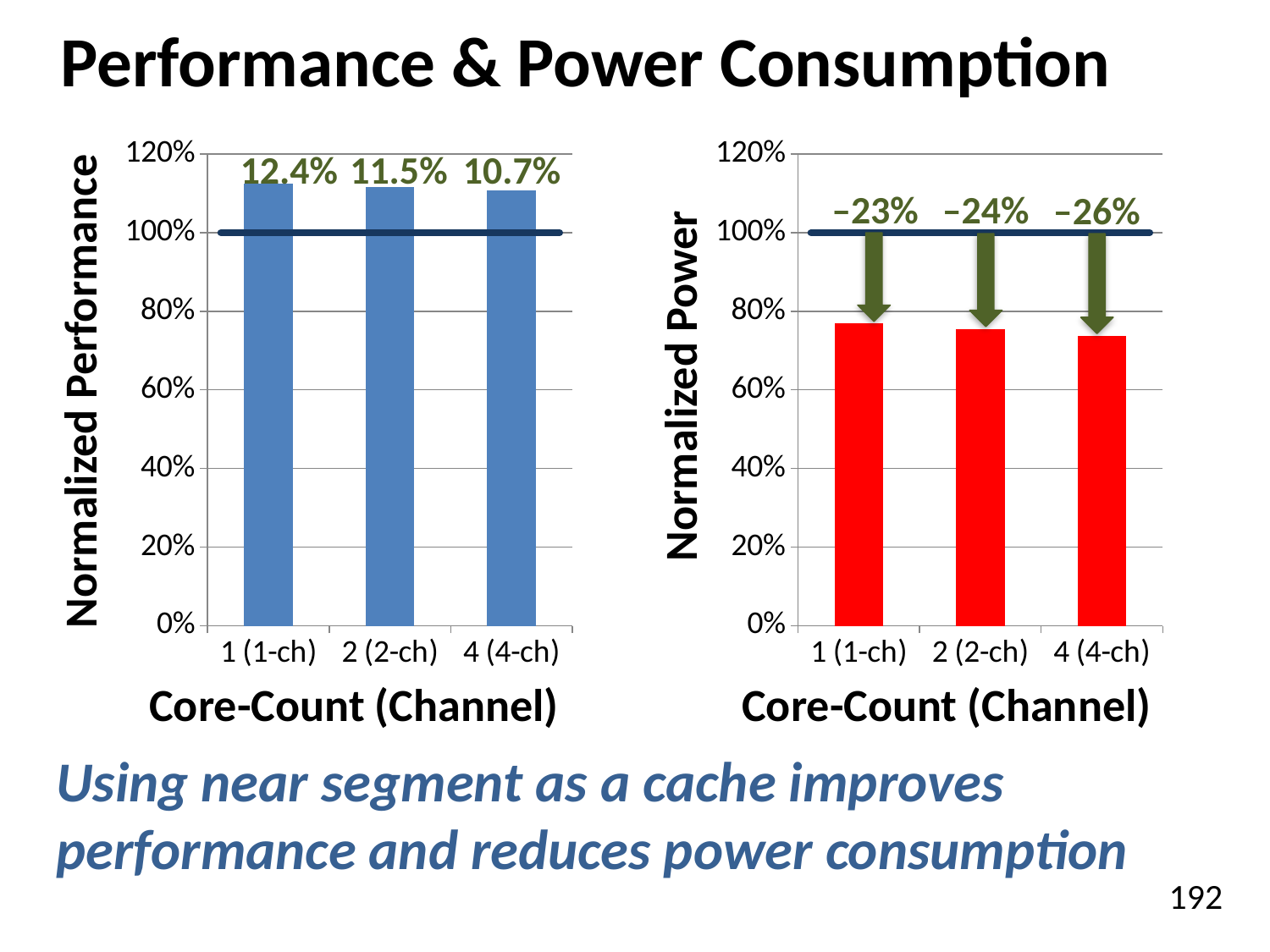
On the Normalized Power chart (right), is the bar for 1 (1-ch) greater or less than 80%? less On the Normalized Performance chart (left), is the bar for 2 (2-ch) greater or less than 100%? greater What kind of chart is the Normalized Performance chart (left)? bar chart What is the x-axis title of the Normalized Power chart (right)? Core-Count (Channel) On the Normalized Performance chart (left), what is the difference between the labelled improvements for 1 (1-ch) and 2 (2-ch)? 0.9% On the Normalized Performance chart (left), which core-count has the largest labelled performance improvement? 1 (1-ch) On the Normalized Power chart (right), what power reduction is labelled for 4 (4-ch)? –26% On the Normalized Power chart (right), what power reduction is labelled for 2 (2-ch)? –24% How many core-count categories are shown on the Normalized Power chart (right)? 3 On the Normalized Performance chart (left), what performance improvement is labelled for 1 (1-ch)? 12.4% On the Normalized Power chart (right), which core-count has the largest labelled power reduction? 4 (4-ch) On the Normalized Performance chart (left), what performance improvement is labelled for 4 (4-ch)? 10.7%